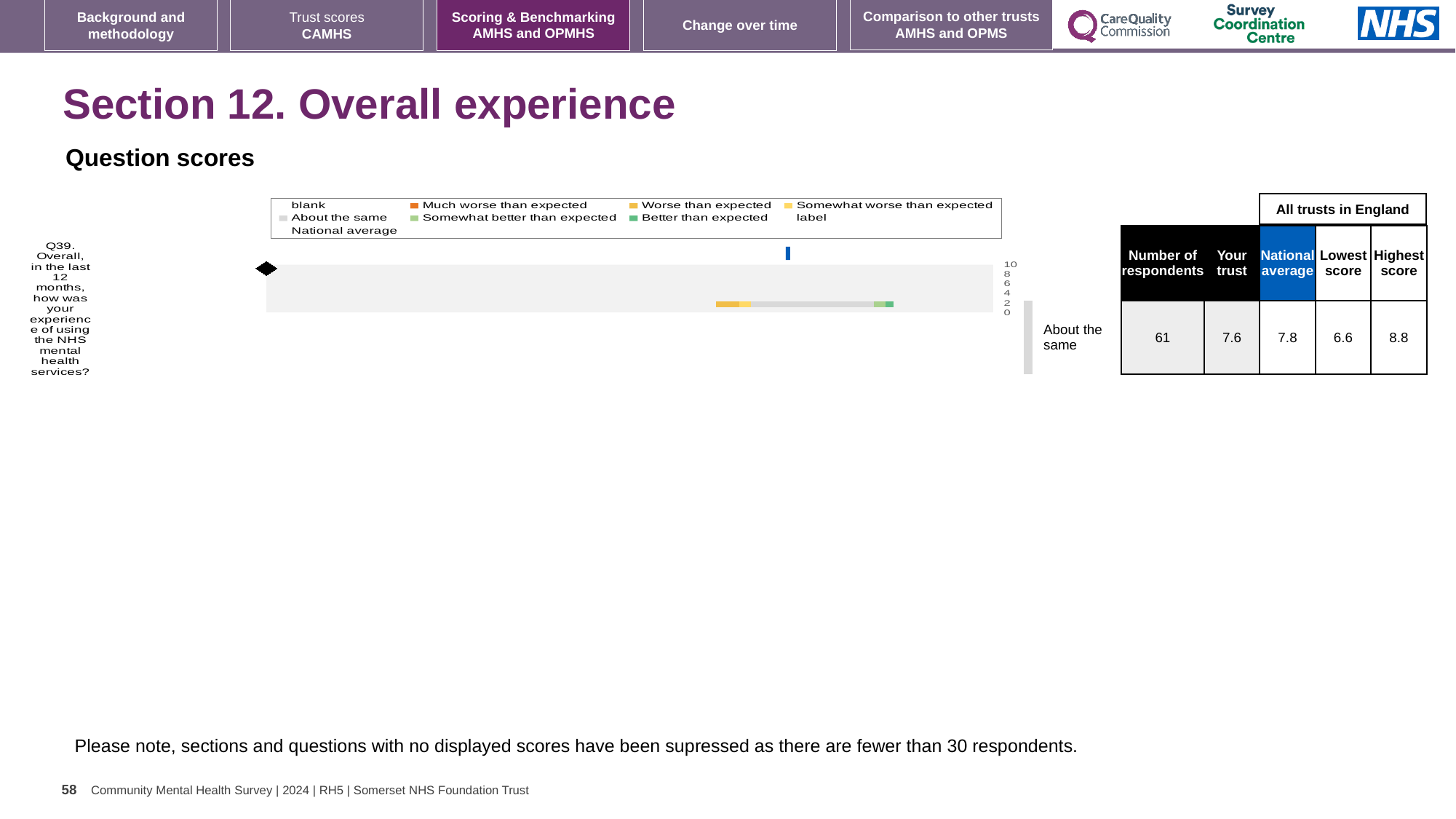
What is the highest value shown on the chart's score axis? 10 According to the table beside the chart, what is the highest score among all trusts in England for Q39? 8.8 Which is larger for Q39: the 'Your trust' score or the national average? National average According to the table beside the chart, what is the 'Your trust' score for Q39? 7.6 According to the table beside the chart, what is the national average score for Q39? 7.8 Which question is plotted in the chart? Q39. Overall, in the last 12 months, how was your experience of using the NHS mental health services? How many questions (categories) are plotted in the chart? 1 According to the table beside the chart, how many respondents answered Q39? 61 How many entries does the chart legend list? 9 Is the national average marker for Q39 on the chart greater or less than 6? greater What kind of chart is shown on the slide? bar chart According to the table beside the chart, what is the lowest score among all trusts in England for Q39? 6.6